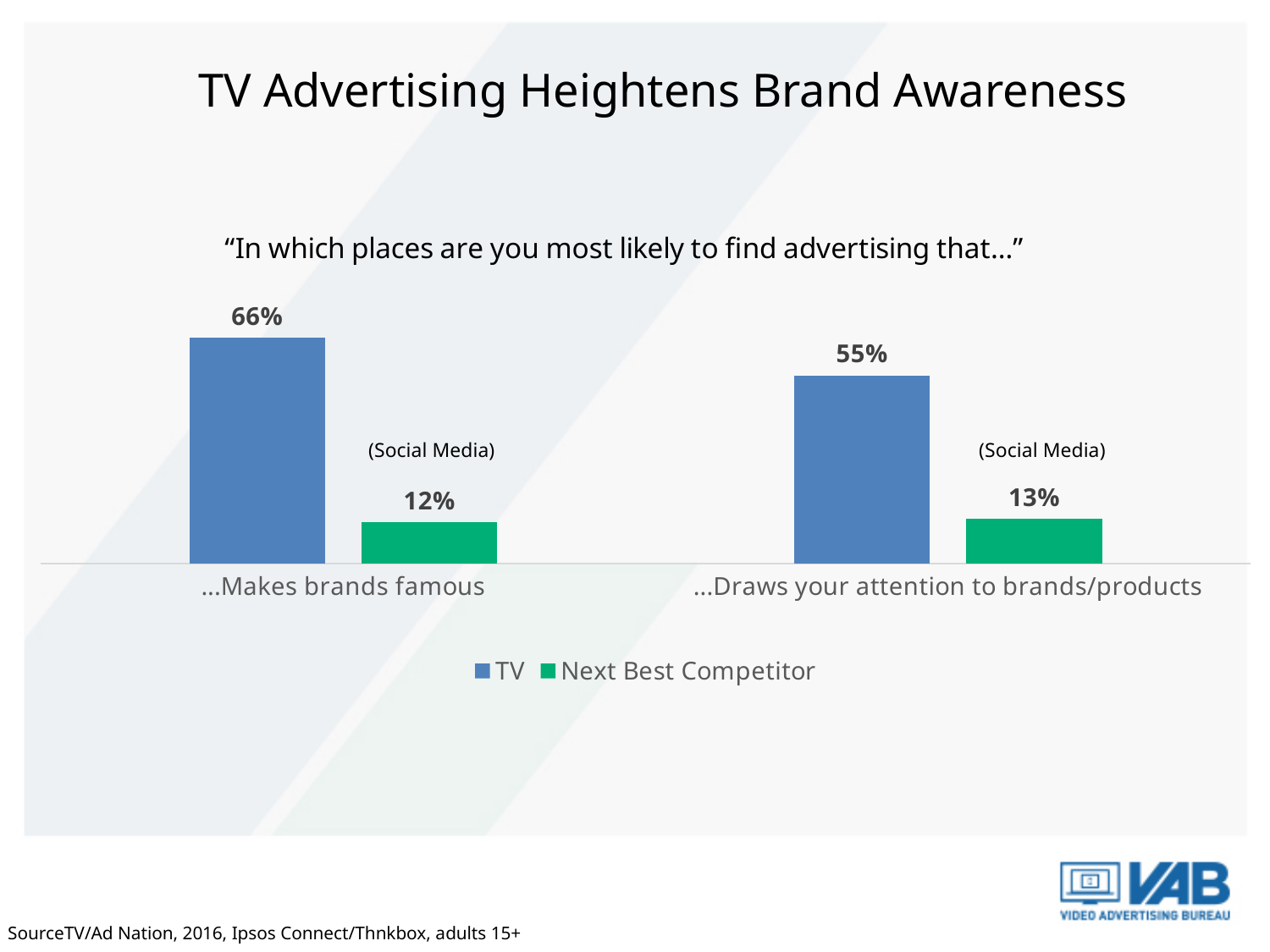
What is the difference between the TV and Next Best Competitor values for "...Draws your attention to brands/products"? 42% How many series does the legend list? 2 Which category has the lowest Next Best Competitor value? ...Makes brands famous What is the difference between the TV and Next Best Competitor values for "...Makes brands famous"? 54% What is the value for TV in the "...Draws your attention to brands/products" category? 55% Which is larger: the TV value for "...Makes brands famous" or the TV value for "...Draws your attention to brands/products"? ...Makes brands famous What is the value for Next Best Competitor in the "...Draws your attention to brands/products" category? 13% Which category has the highest TV value? ...Makes brands famous What is the value for TV in the "...Makes brands famous" category? 66% What kind of chart is shown on the slide? Bar chart What is the value for Next Best Competitor in the "...Makes brands famous" category? 12% How many categories are shown on the x axis? 2